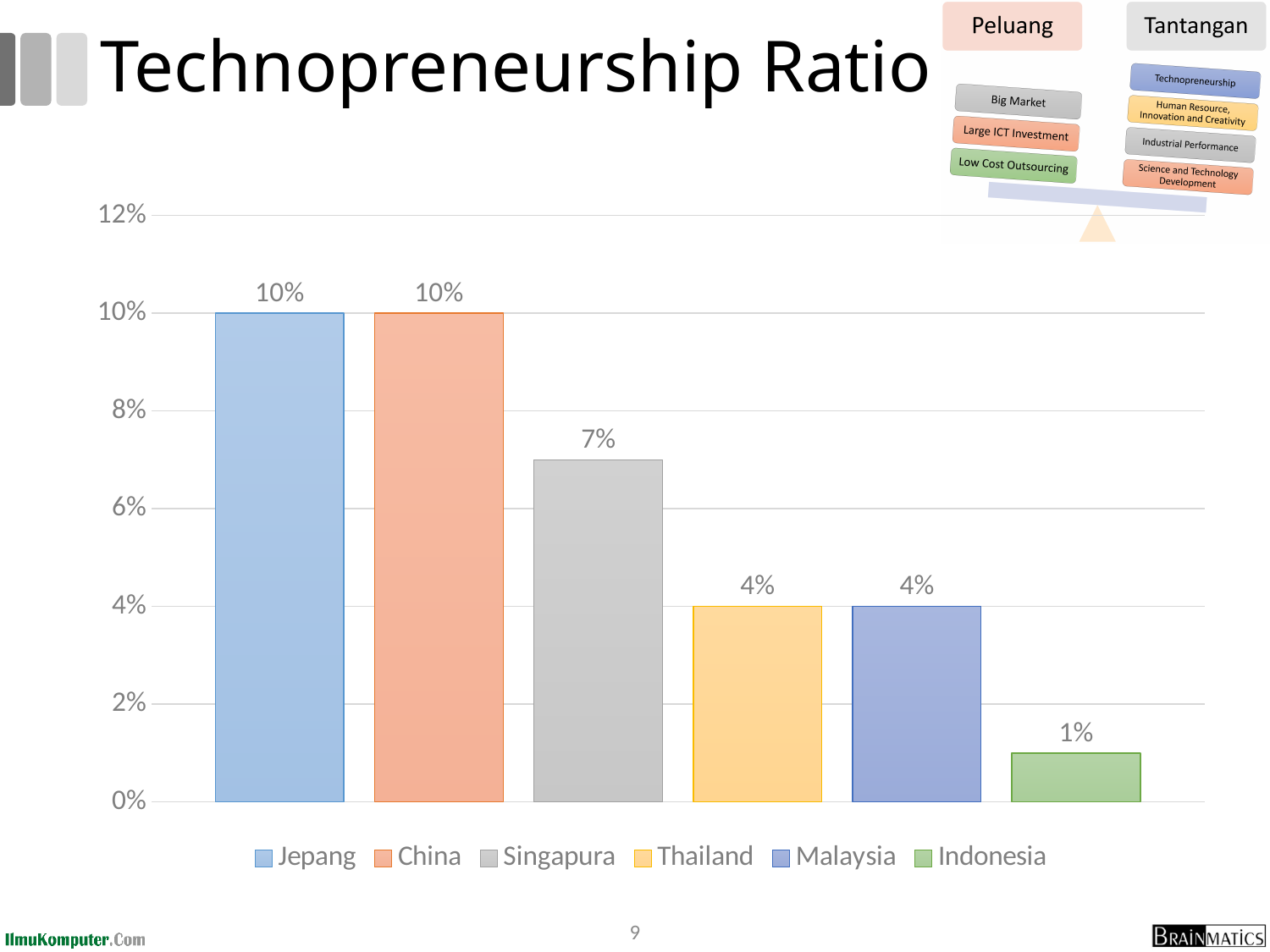
Which is larger, the technopreneurship ratio of Thailand or Indonesia? Thailand How many entries does the legend list? 6 What is the difference between the technopreneurship ratio of Malaysia and Indonesia? 3% What is the difference between the technopreneurship ratio of Jepang and Singapura? 3% What is the technopreneurship ratio for Indonesia? 1% Which country has the lowest technopreneurship ratio? Indonesia What is the technopreneurship ratio for Thailand? 4% How many countries are shown in the chart? 6 What kind of chart is shown on the slide? Bar chart Which is larger, the technopreneurship ratio of China or Singapura? China What is the technopreneurship ratio for Singapura? 7% Do the values generally rise or fall from left to right across the countries? Fall